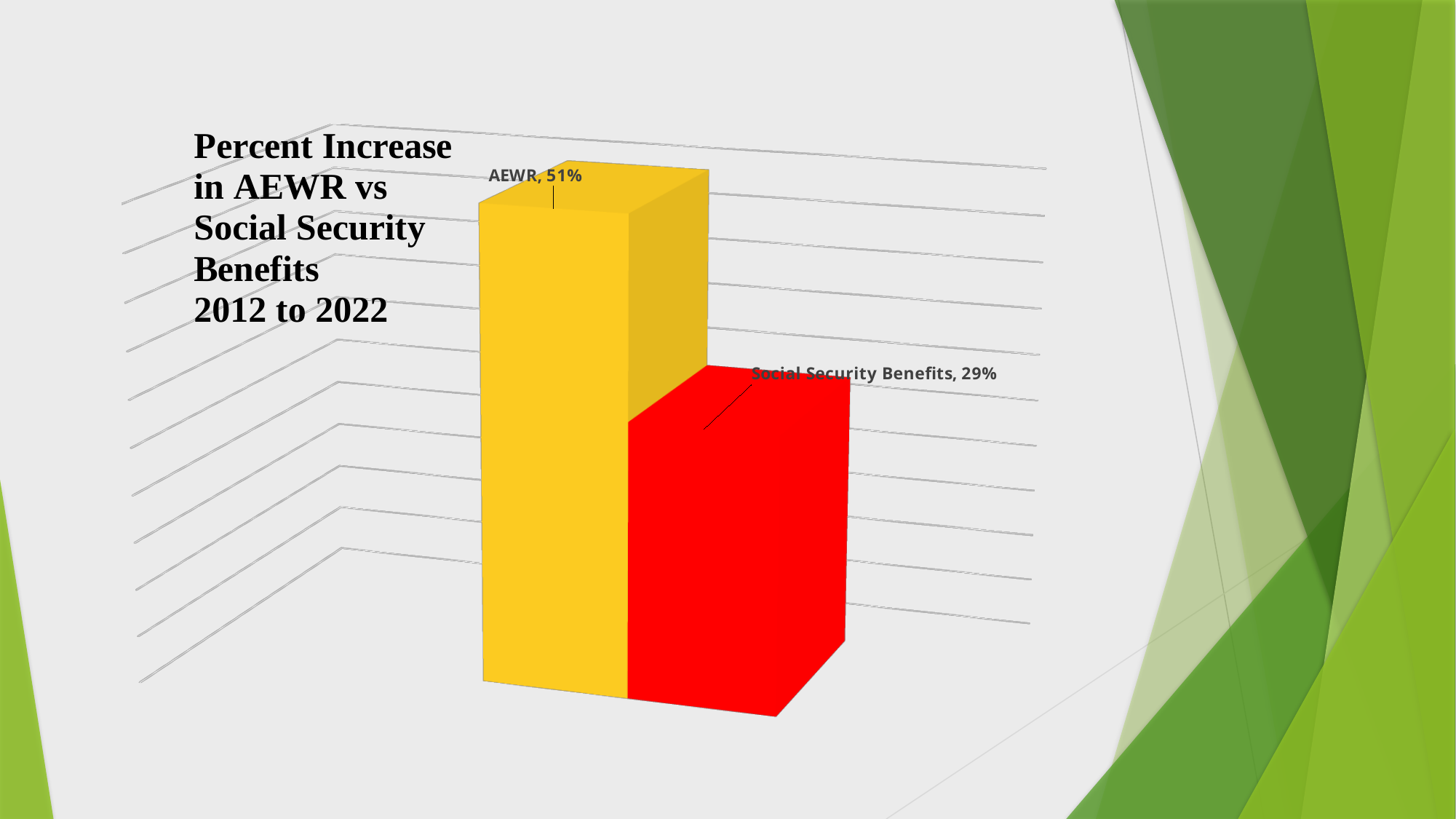
What is the percent increase shown for AEWR? 51% Which category has the lower percent increase? Social Security Benefits What is the percent increase shown for Social Security Benefits? 29% Is the value for AEWR larger or smaller than the value for Social Security Benefits? larger What is the difference in percentage points between the AEWR increase and the Social Security Benefits increase? 22 What colour is the bar for Social Security Benefits? red Which category has the higher percent increase? AEWR How many categories are plotted in the chart? 2 What is the title of the chart? Percent Increase in AEWR vs Social Security Benefits 2012 to 2022 What kind of chart is shown on the slide? bar chart